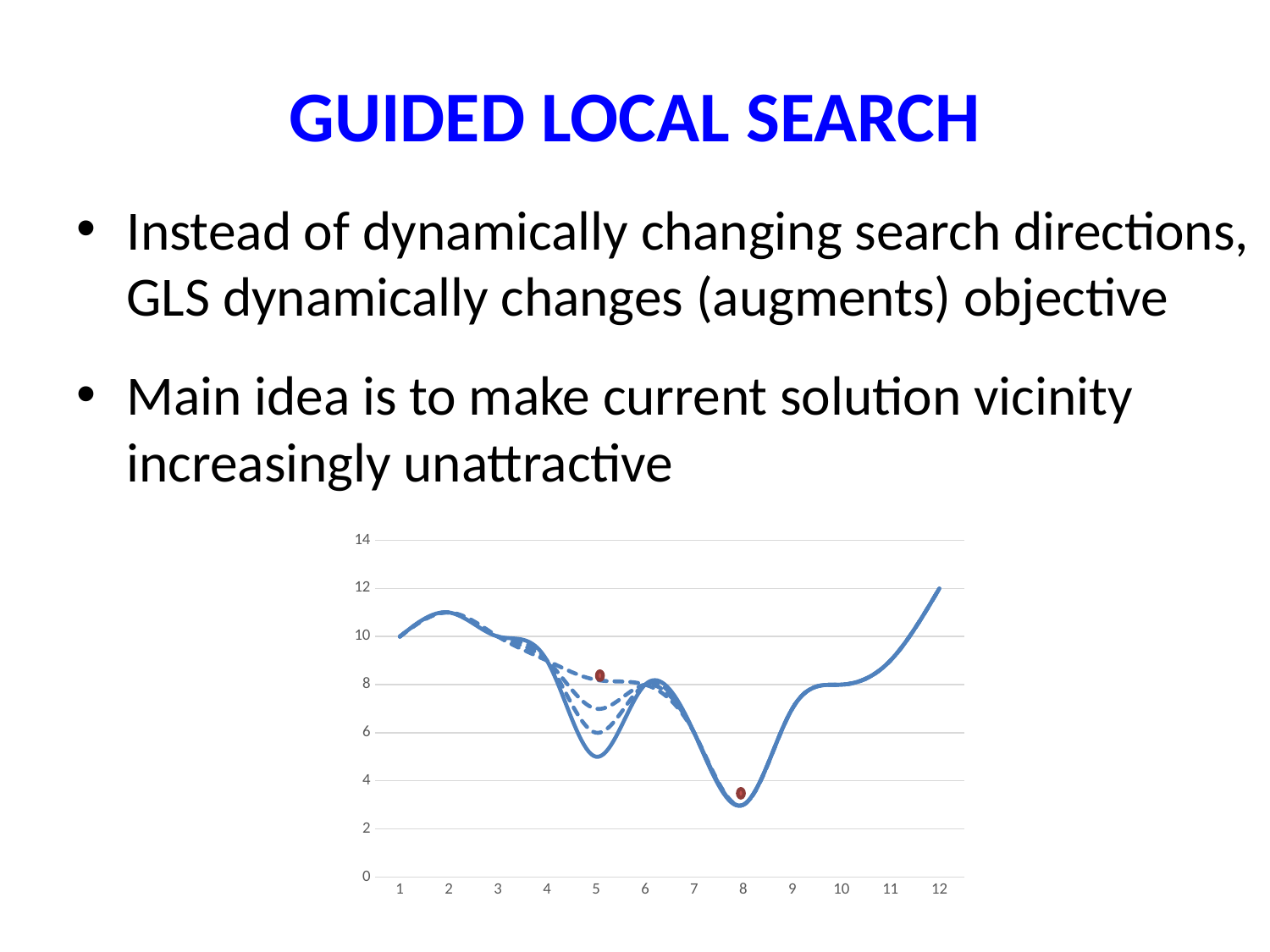
What is the value of the solid line at x = 1? 10 Which is larger, the value of the solid line at x = 5 or at x = 8? x = 5 Is the value of the solid line at x = 5 greater or less than 6? less What kind of chart is shown on the slide? line chart At which x value does the solid line reach its lowest point? 8 Is the value of the solid line at x = 8 greater or less than 4? less At which x value does the solid line reach its highest point? 12 Is the value of the solid line at x = 2 greater or less than 10? greater What is the value of the solid line at x = 12? 12 Does the solid line rise or fall between x = 8 and x = 12? rise How many points are labelled along the x axis of the chart? 12 How many red dots are marked on the chart? 2